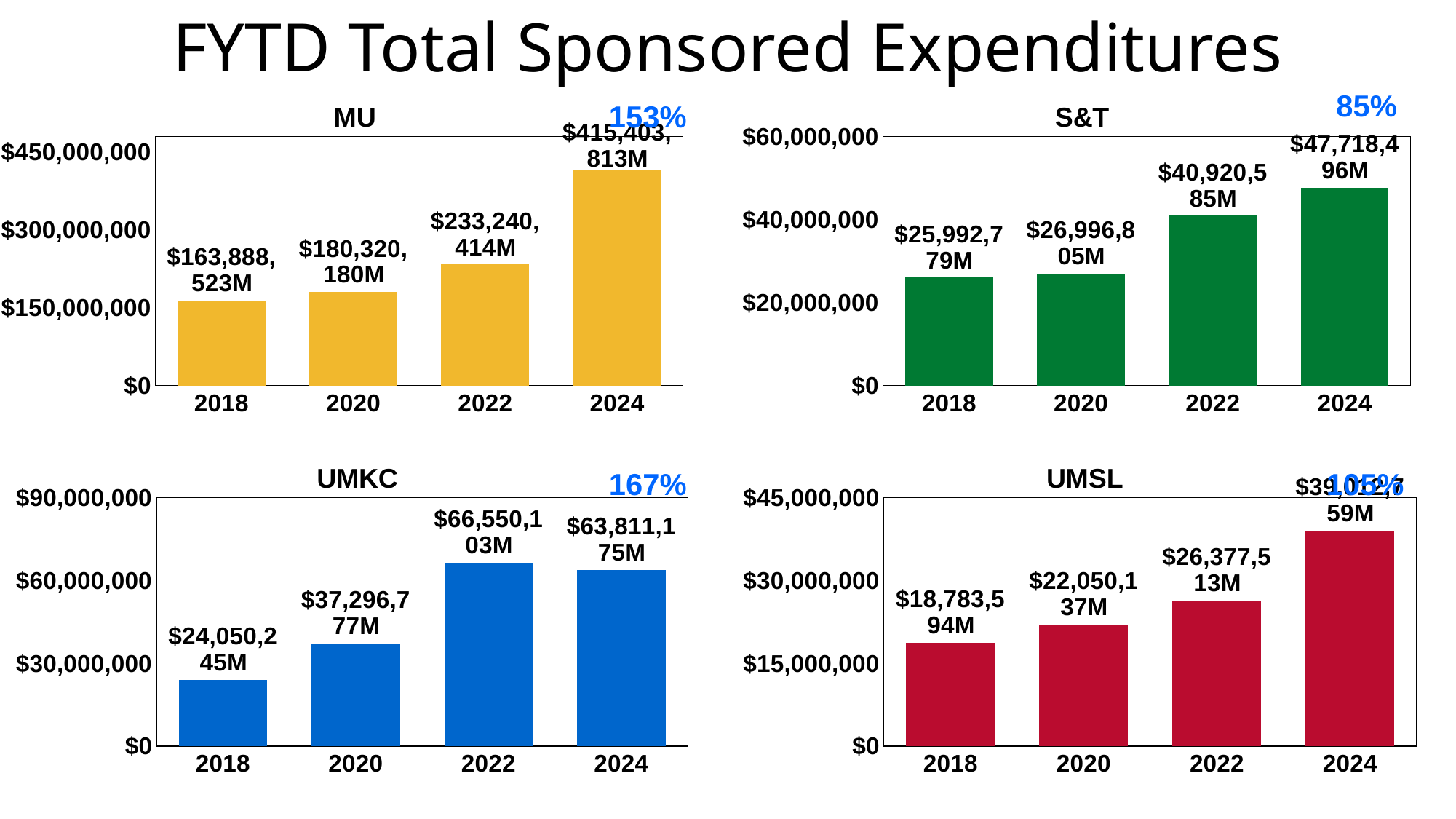
In the UMKC chart, which year has the highest value? 2022 In the S&T chart, what is the value for 2024? $47,718,496M In the UMKC chart, what is the value for 2020? $37,296,777M In the UMSL chart, which year has the lowest value? 2018 In the MU chart, do the values rise or fall from 2018 to 2024? rise How many bars are in the S&T chart? 4 In the MU chart, what is the value for 2022? $233,240,414M In the UMSL chart, is the value for 2024 greater or less than $30,000,000? greater In the MU chart, which is larger, the value for 2018 or the value for 2020? 2020 In the UMKC chart, what is the difference between the 2022 and 2024 values? $2,738,928M In the S&T chart, what is the difference between the 2020 and 2018 values? $1,004,026M What kind of chart is the MU chart? bar chart